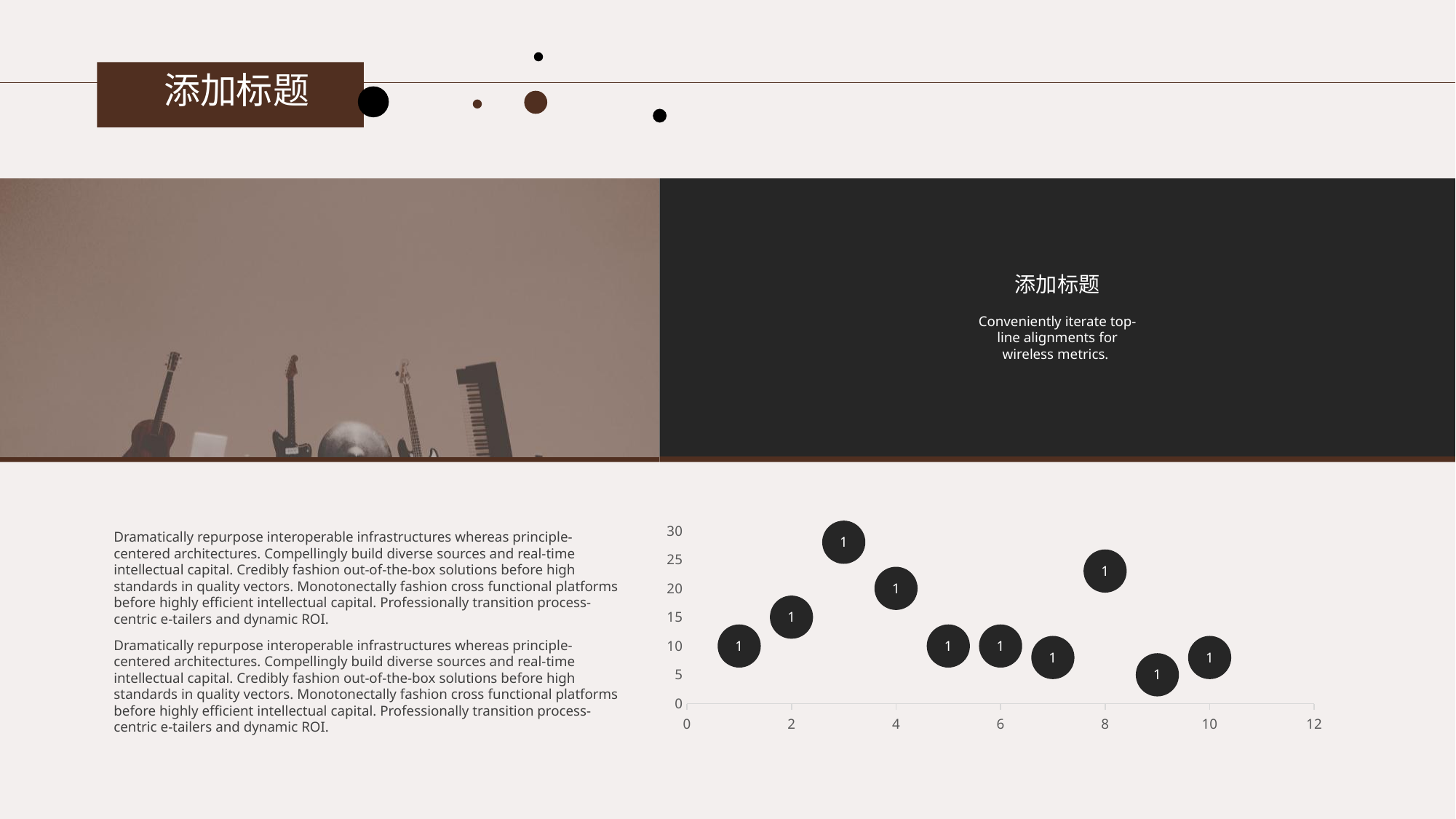
Which bubble is higher on the y axis, the one at x = 2 or the one at x = 4? x = 4 At which x value is the highest bubble in the chart? 3 At which x value is the lowest bubble in the chart? 9 Is the y value of the bubble at x = 1 greater or less than 15? less Which bubble is higher on the y axis, the one at x = 3 or the one at x = 8? x = 3 What data label is printed inside each bubble in the chart? 1 Is the y value of the bubble at x = 9 greater or less than 10? less Is the y value of the bubble at x = 8 greater or less than 20? greater What kind of chart is shown at the bottom right of the slide? bubble chart What is the highest value shown on the chart's y axis? 30 How many bubbles are plotted in the chart? 10